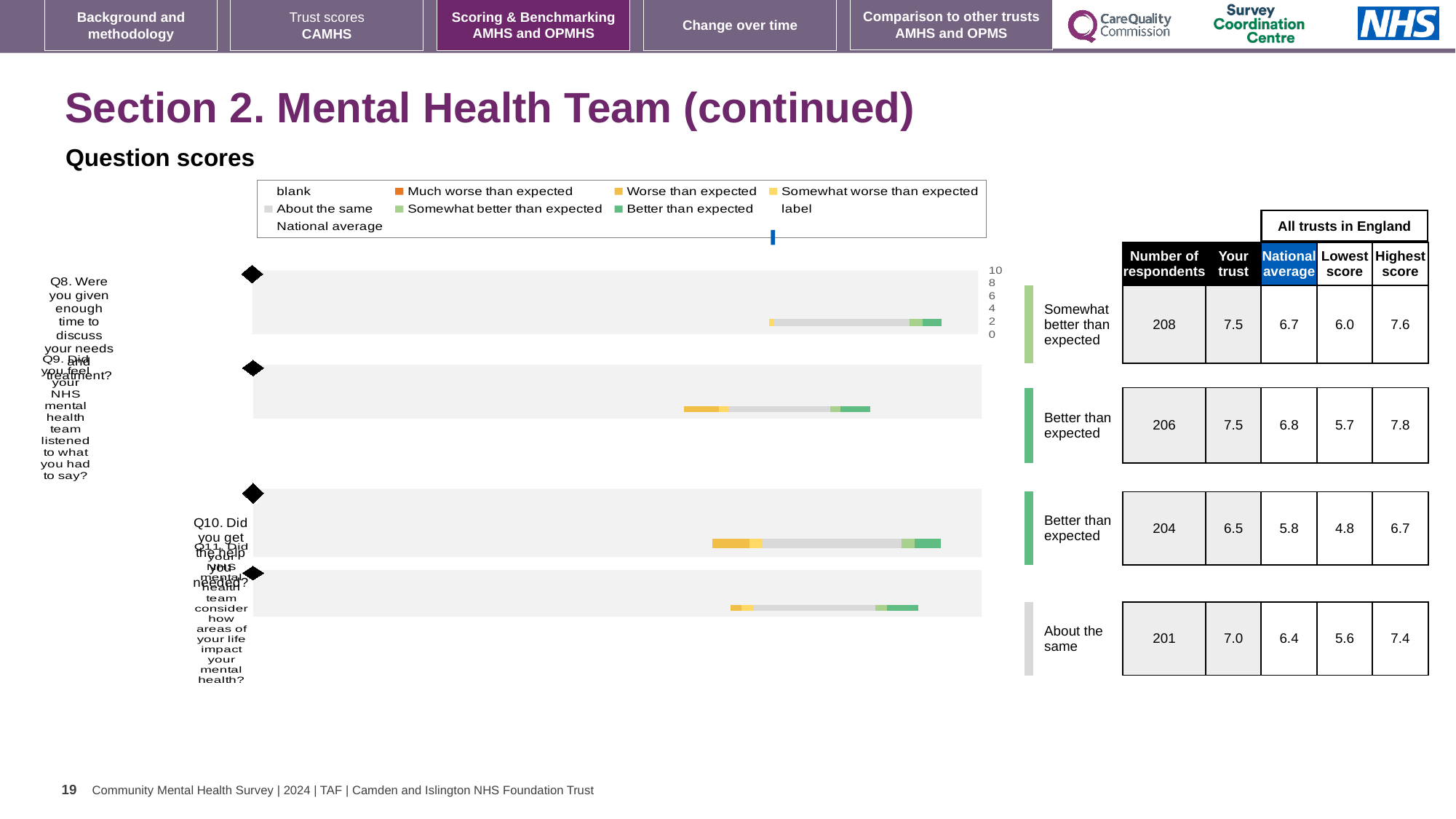
In the table beside the chart, what is the 'Your trust' score for Q10? 6.5 In the table beside the chart, what is the number of respondents for Q8? 208 What is the difference between the 'Your trust' score and the national average for Q8? 0.8 Which question has the highest number of respondents in the table beside the chart? Q8 What benchmark category is shown next to the Q11 bar? About the same Is the 'Your trust' score for Q9 larger or smaller than the 'Your trust' score for Q11? larger What benchmark category is shown next to the Q8 bar? Somewhat better than expected In the table beside the chart, what is the national average for Q9? 6.8 What kind of chart is shown under 'Question scores'? bar chart Which question has the lowest 'Your trust' score in the table beside the chart? Q10 In the table beside the chart, what is the highest score for Q11? 7.4 How many questions (bars) are plotted in the chart? 4